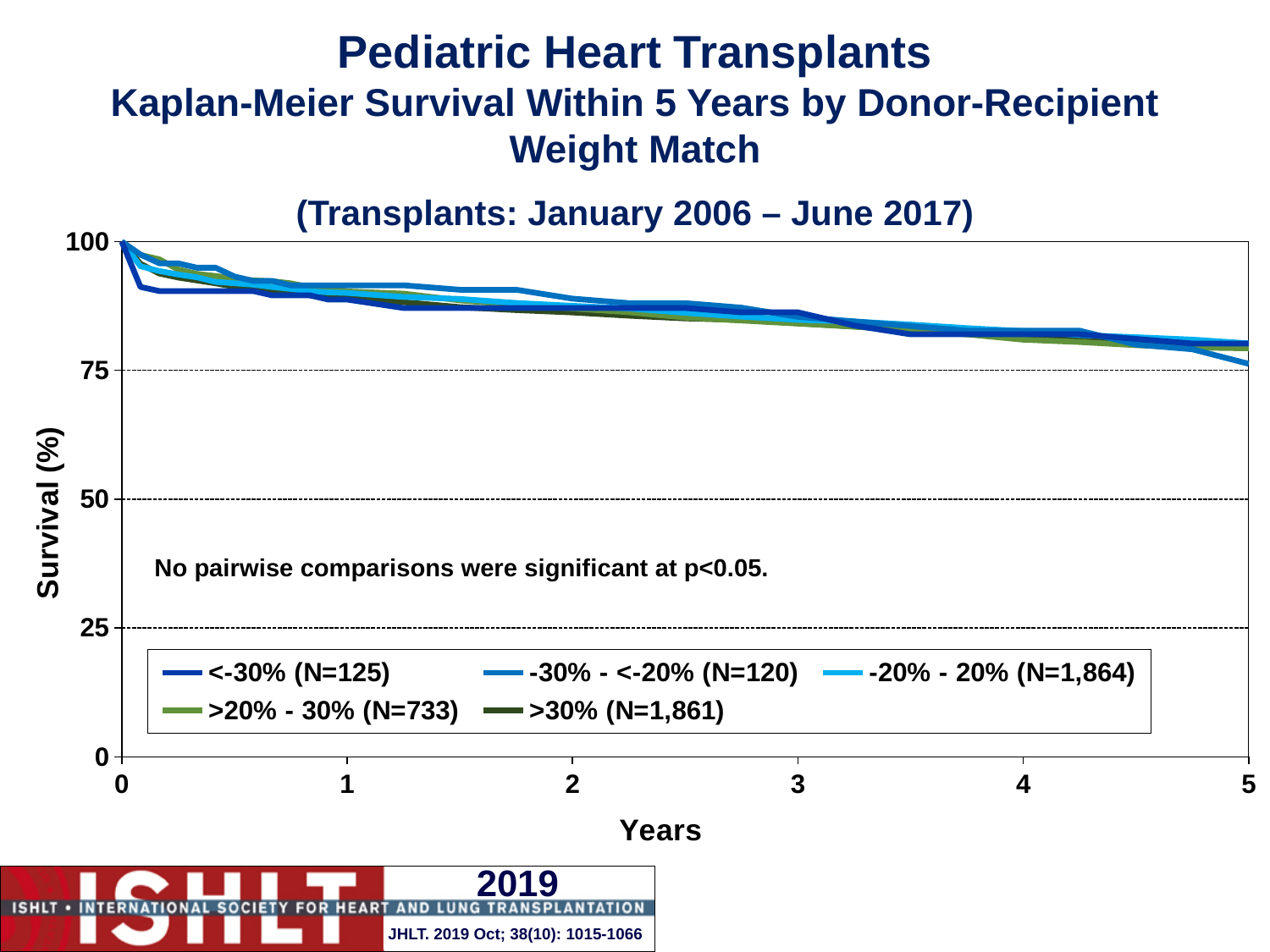
What kind of chart is shown on the slide? line chart What is the maximum value shown on the x axis (Years)? 5 Do the survival curves rise or fall as the years increase? fall What note is printed inside the plot area about pairwise comparisons? No pairwise comparisons were significant at p<0.05. How many tick marks are labelled on the x axis? 6 Is the survival value for the <-30% (N=125) group at 3 years greater or less than 100? less Is the survival value for the >20% - 30% (N=733) group at 2 years greater or less than 75? greater Is the survival value for the >30% (N=1,861) group at 1 year greater or less than 75? greater How many series does the legend list? 5